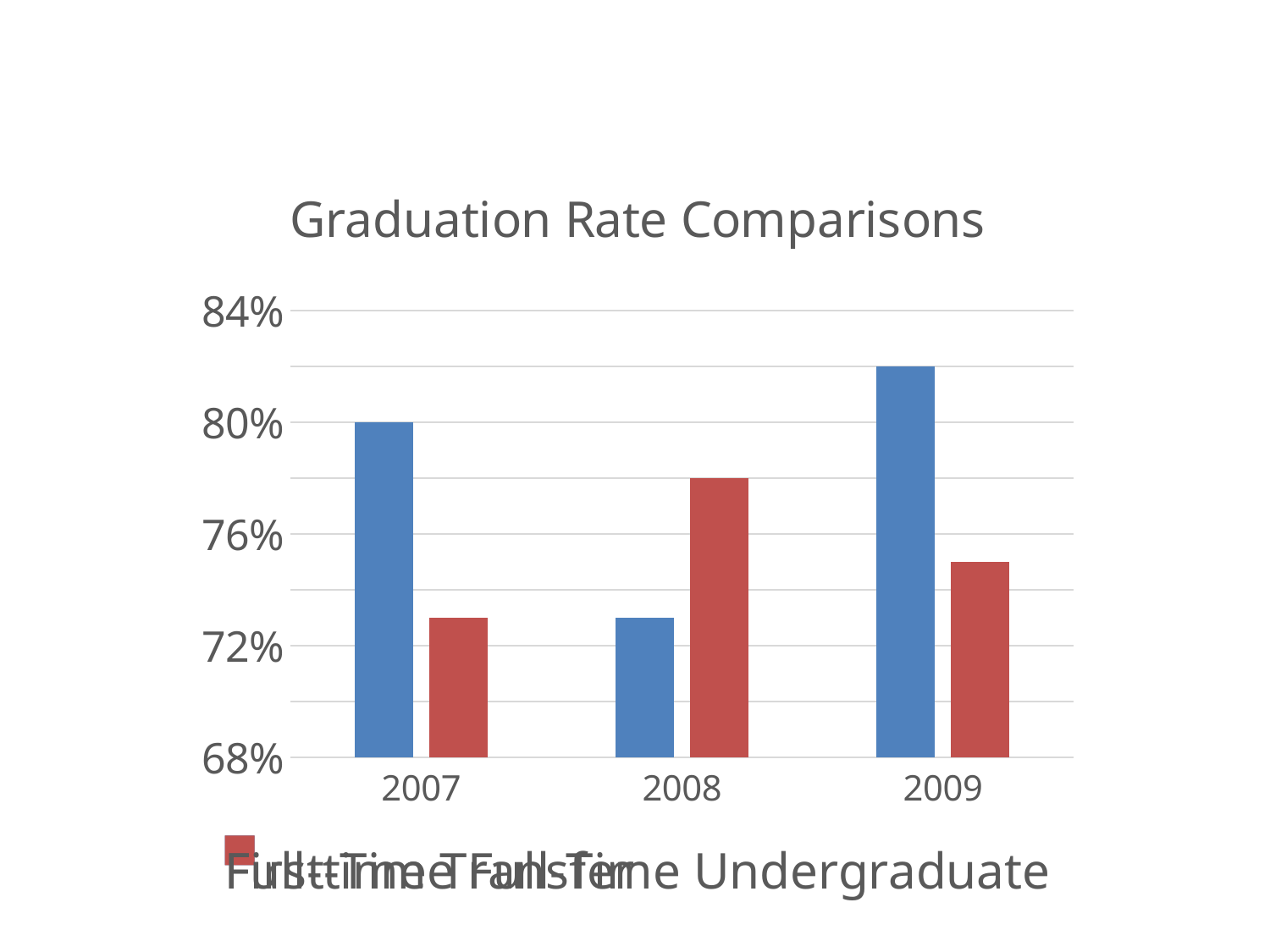
What is the value of the blue bar for 2007? 80% How many years are shown on the x axis of the chart? 3 Is the value of the blue bar for 2008 greater or less than 76%? less Is the value of the red bar for 2008 greater or less than 76%? greater Is the value of the blue bar for 2009 greater or less than 80%? greater How many series of bars are plotted for each year? 2 What is the title of the chart? Graduation Rate Comparisons In which year is the blue bar highest? 2009 In which year is the red bar lowest? 2007 For 2008, which bar is larger, the blue bar or the red bar? the red bar What kind of chart is shown on the slide? bar chart